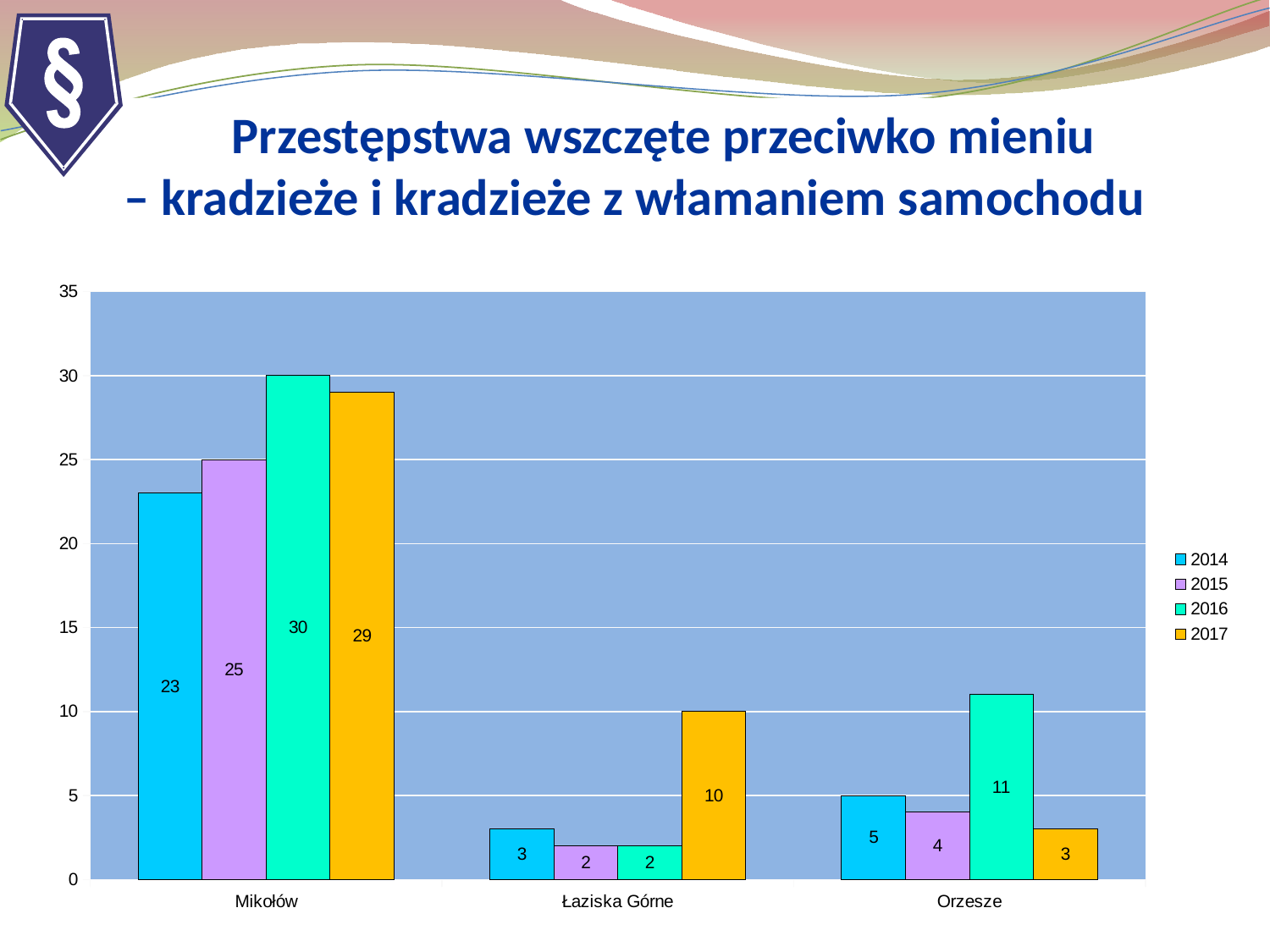
What is the value for Mikołów in 2016? 30 Is the value for Mikołów in 2017 greater or less than 25? greater Which is larger for Łaziska Górne: the 2014 value or the 2017 value? 2017 What is the total of the four values for Orzesze? 23 Which year has the lowest value for Orzesze? 2017 What kind of chart is shown on the slide? bar chart What is the value for Orzesze in 2015? 4 What is the difference between the 2016 and 2014 values for Mikołów? 7 Which category has the highest value in 2014? Mikołów How many categories are shown on the x axis? 3 What is the value for Łaziska Górne in 2017? 10 How many series does the legend list? 4